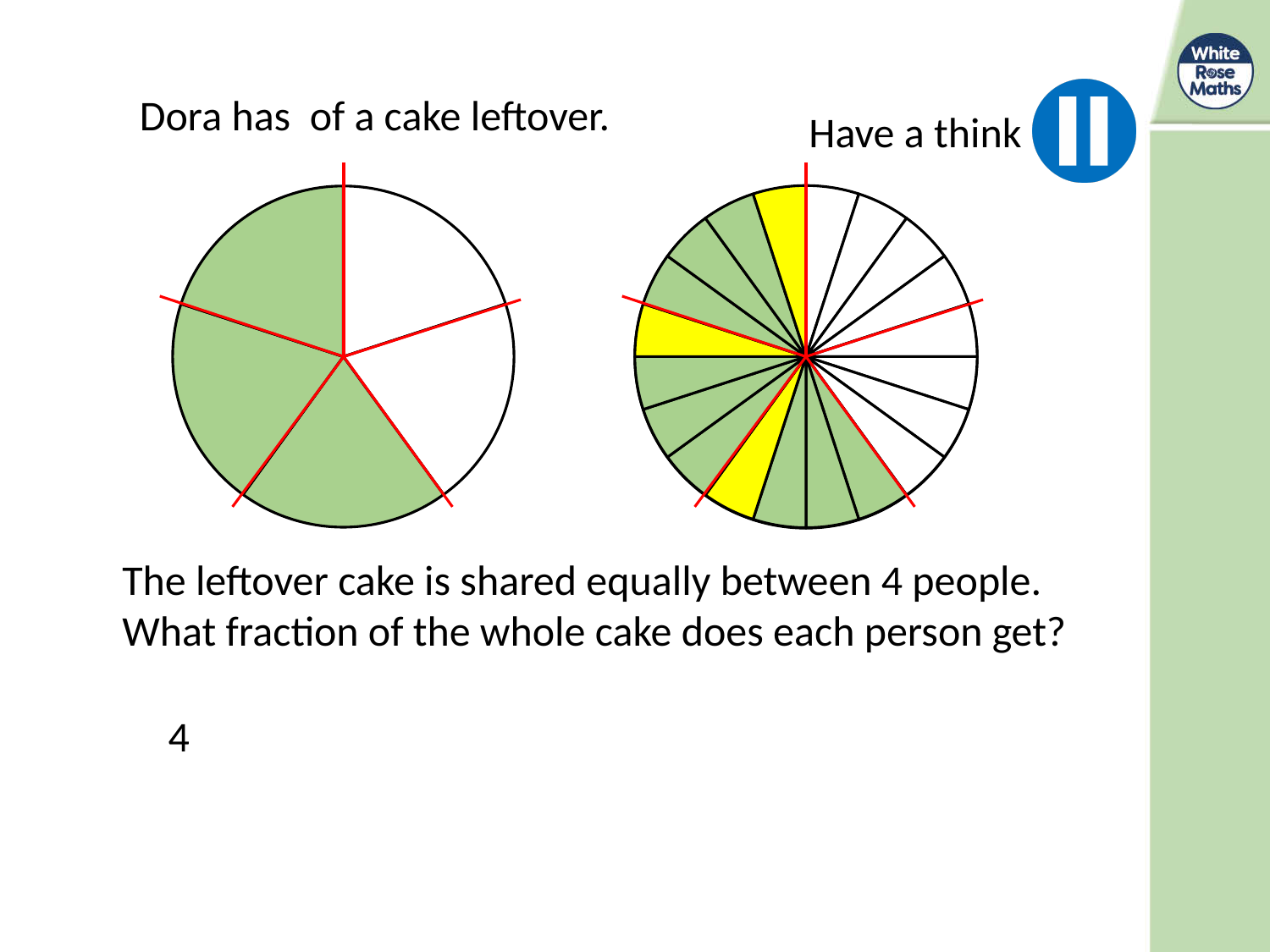
Into how many smaller sections is each fifth of the right circle split? 4 What colour are the lines that divide both circles into fifths? Red What fraction of the left circle is shaded green? 3/5 How many sections of the left circle are shaded green? 3 How many sections of the left circle are left white (unshaded)? 2 Which colour is used for the shaded sections of the left circle? Green What fraction of the right circle is shaded yellow? 3/20